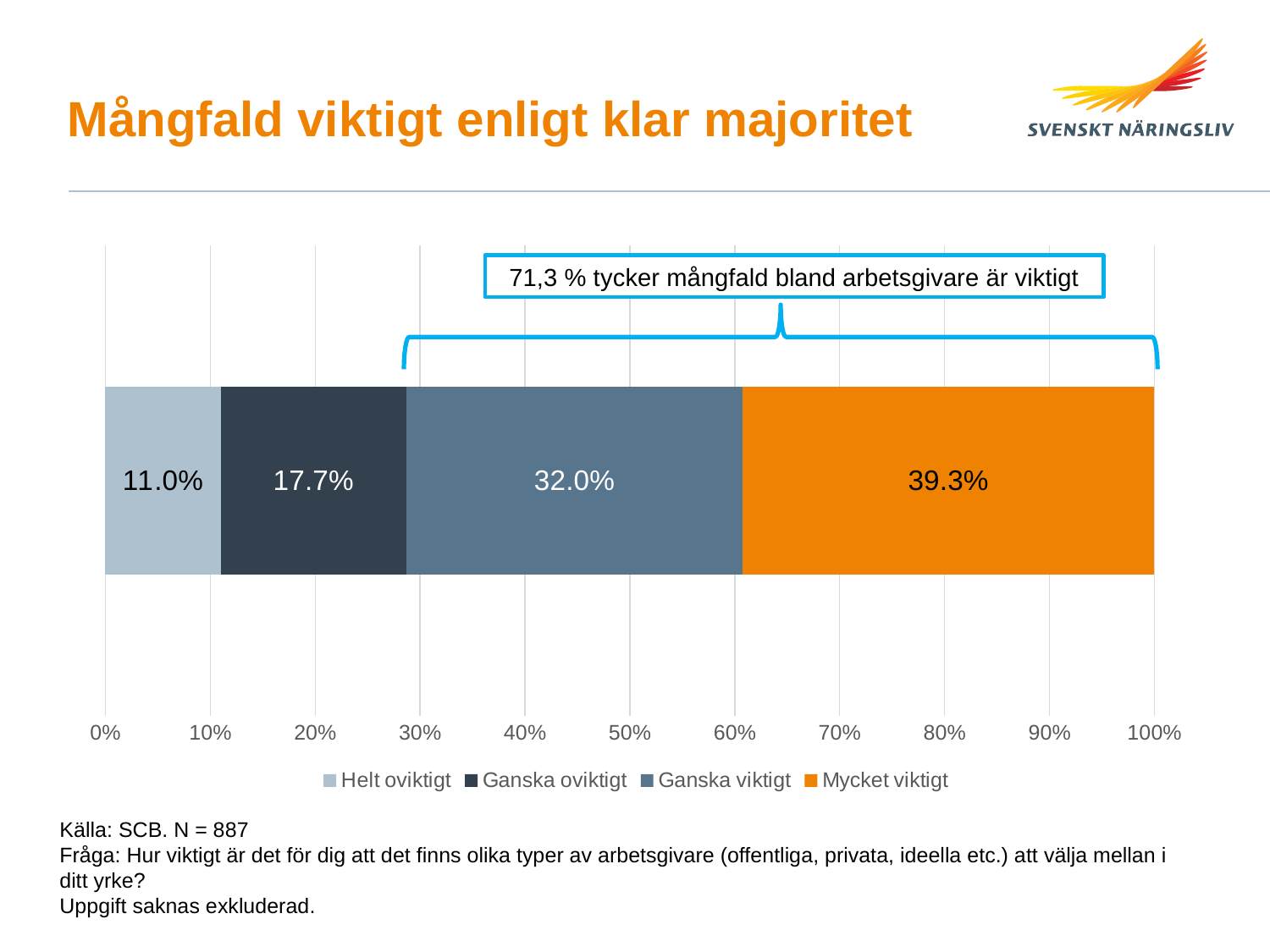
What percentage of respondents answered "Ganska viktigt"? 32.0% Which response category has the largest share? Mycket viktigt What percentage of respondents answered "Ganska oviktigt"? 17.7% What is the title of the slide? Mångfald viktigt enligt klar majoritet How many series does the legend list? 4 What kind of chart is shown on the slide? Stacked bar chart Which is larger, the share for "Ganska oviktigt" or the share for "Helt oviktigt"? Ganska oviktigt Which response category has the smallest share? Helt oviktigt What is the difference in percentage points between "Mycket viktigt" and "Ganska viktigt"? 7.3 What percentage of respondents answered "Helt oviktigt"? 11.0% What is the combined share of "Ganska viktigt" and "Mycket viktigt"? 71.3% What percentage of respondents answered "Mycket viktigt"? 39.3%